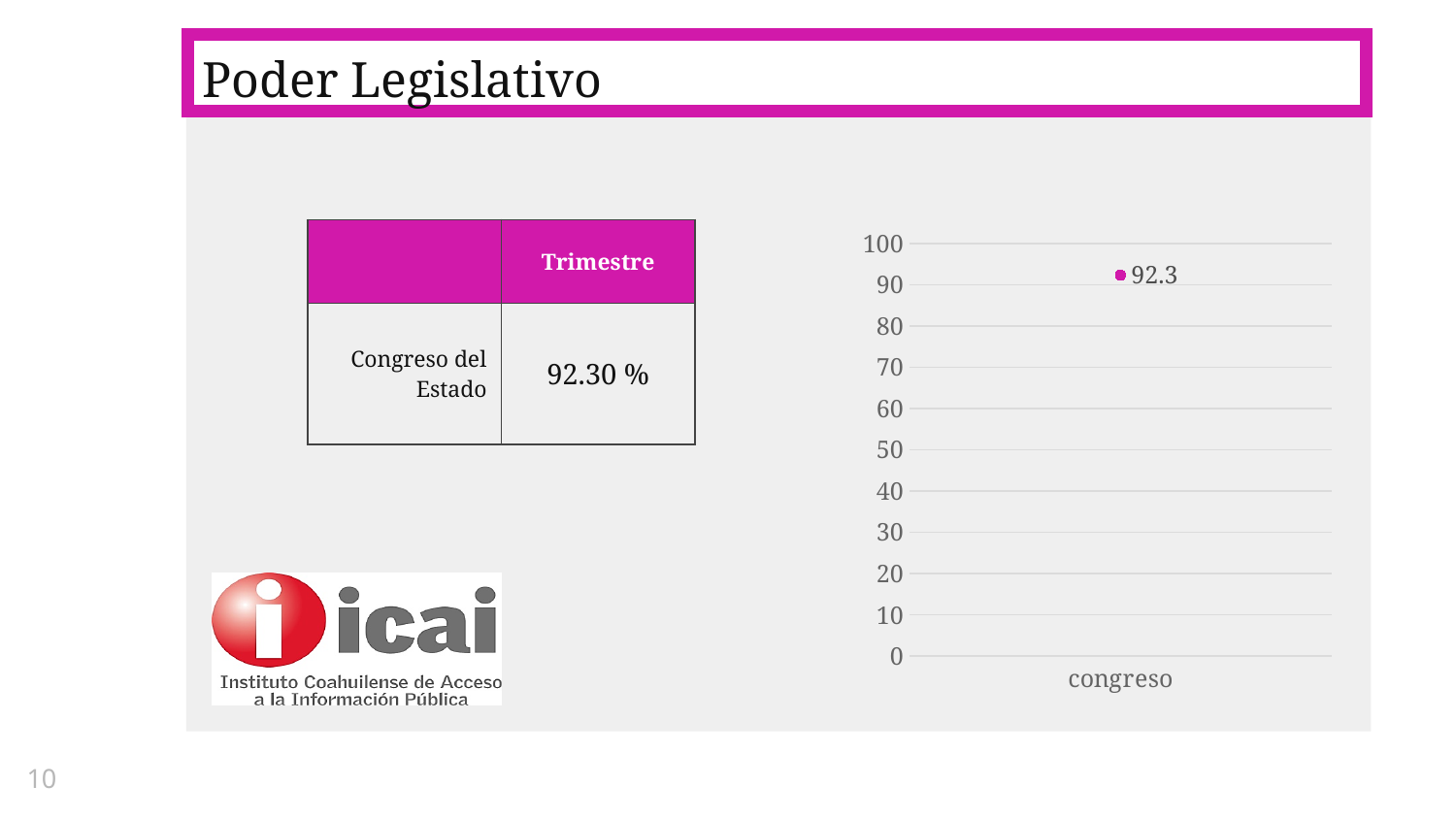
What is the value plotted for congreso? 92.3 Is the value for congreso greater or less than 100? less What is the label of the category on the x axis of the chart? congreso What is the highest tick value shown on the y axis of the chart? 100 Is the value for congreso greater or less than 50? greater How many data points are plotted on the chart? 1 How many categories are shown on the x axis of the chart? 1 Is the value for congreso greater or less than 90? greater